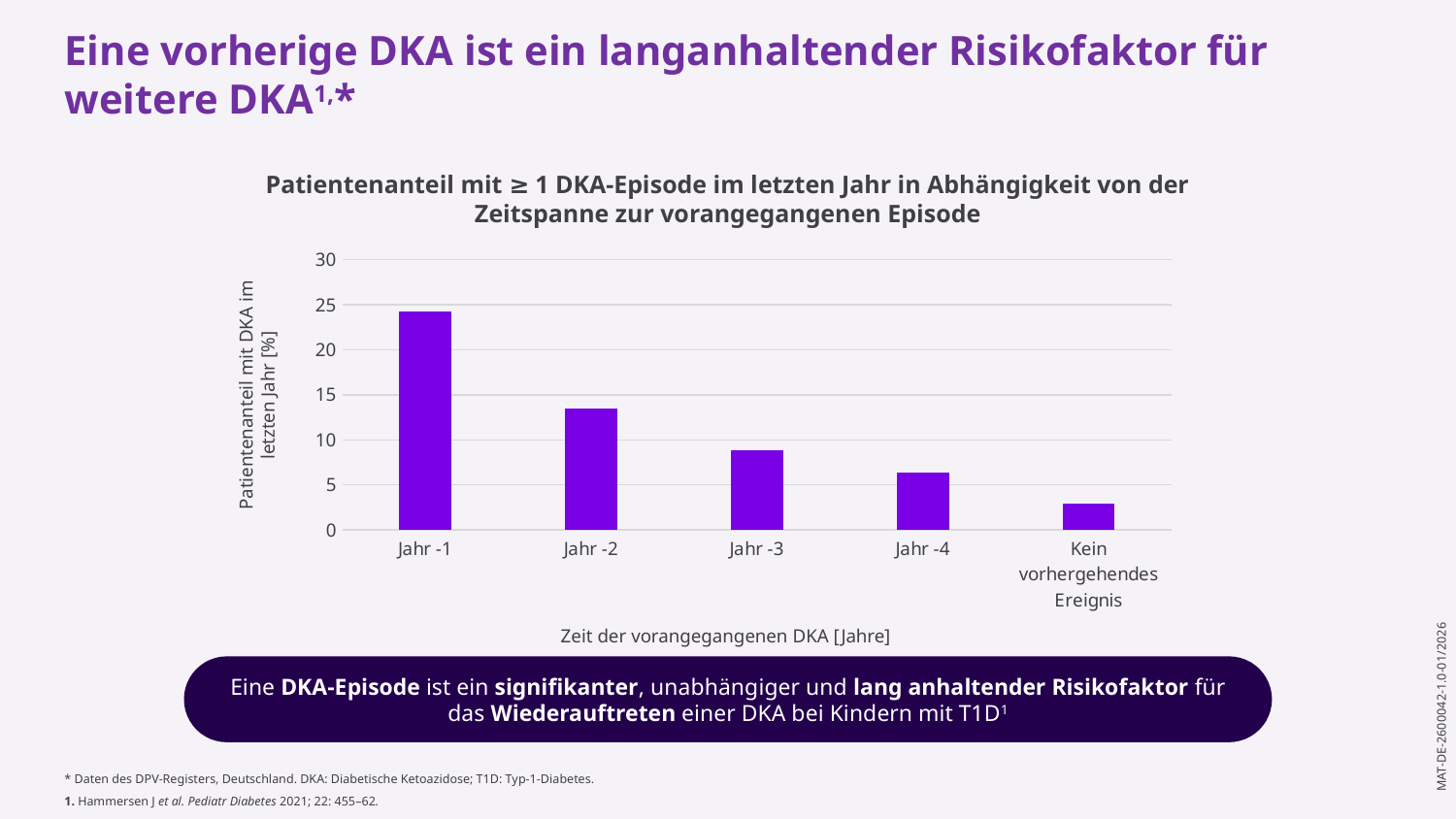
Is the value for Kein vorhergehendes Ereignis greater or less than 5? less Is the value for Jahr -2 greater or less than 15? less Do the values rise or fall from Jahr -1 to Kein vorhergehendes Ereignis along the x axis? fall Is the value for Jahr -4 greater or less than 5? greater Which is larger, the value for Jahr -2 or the value for Jahr -3? Jahr -2 Which category has the highest value in the chart? Jahr -1 Which category has the lowest value in the chart? Kein vorhergehendes Ereignis What is the label of the y axis of the chart? Patientenanteil mit DKA im letzten Jahr [%] What kind of chart is shown on the slide? bar chart How many categories are shown on the x axis of the chart? 5